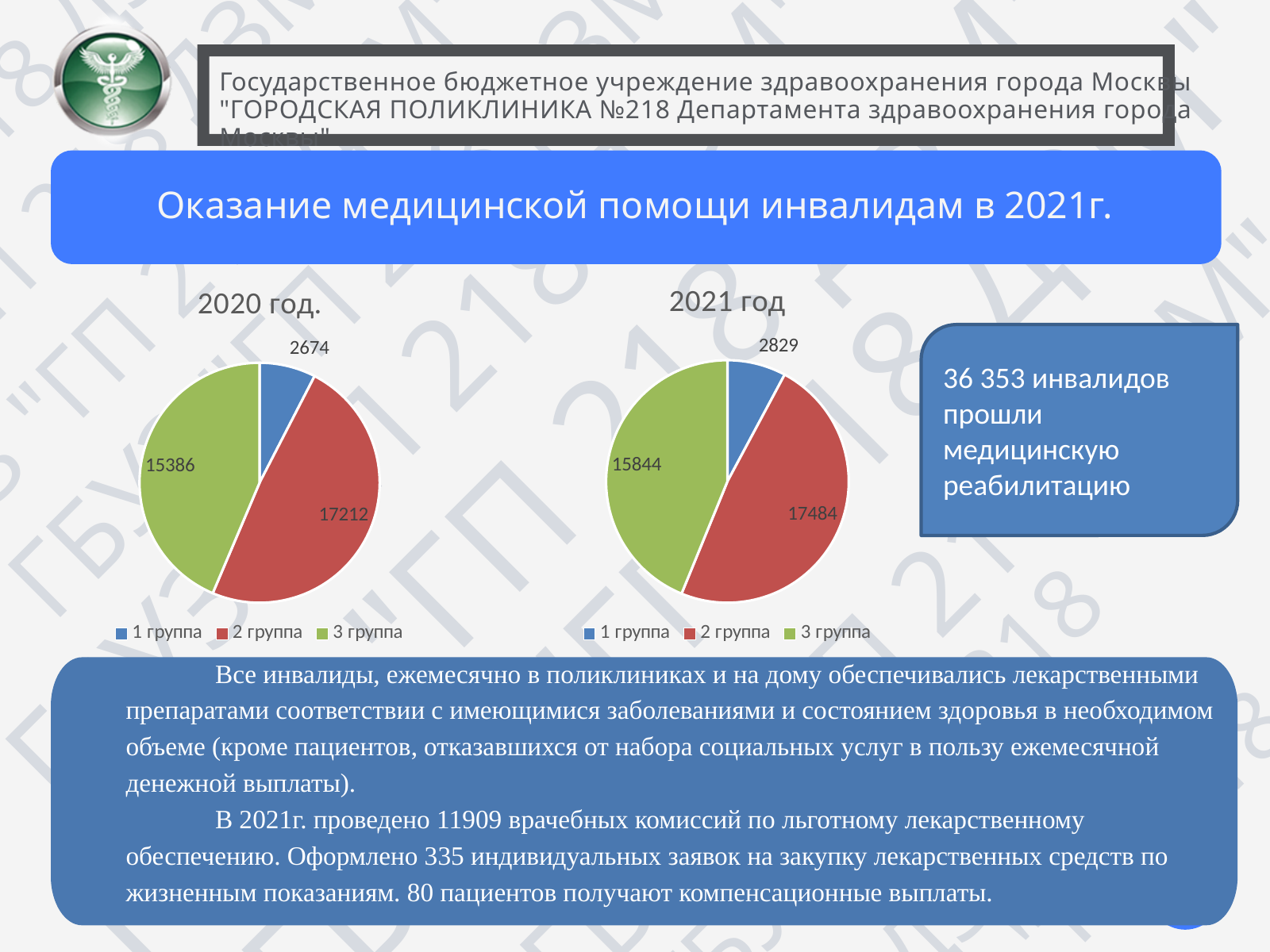
How many entries does the legend of the "2020 год." chart list? 3 In the "2020 год." chart, what colour is the slice for 3 группа? green In the "2021 год" chart, which group has the smallest slice? 1 группа Which is larger: the 3 группа value in the "2020 год." chart or the 3 группа value in the "2021 год" chart? 2021 год In the "2020 год." chart, what is the value for 2 группа? 17212 In the "2020 год." chart, which group has the largest slice? 2 группа How many slices does the "2021 год" chart have? 3 What type of chart is the "2021 год" chart? pie chart In the "2021 год" chart, what is the value for 1 группа? 2829 In the "2021 год" chart, what is the value for 3 группа? 15844 What is the difference between the 2 группа value in the "2021 год" chart and the 2 группа value in the "2020 год." chart? 272 In the "2020 год." chart, what is the difference between the values for 2 группа and 3 группа? 1826